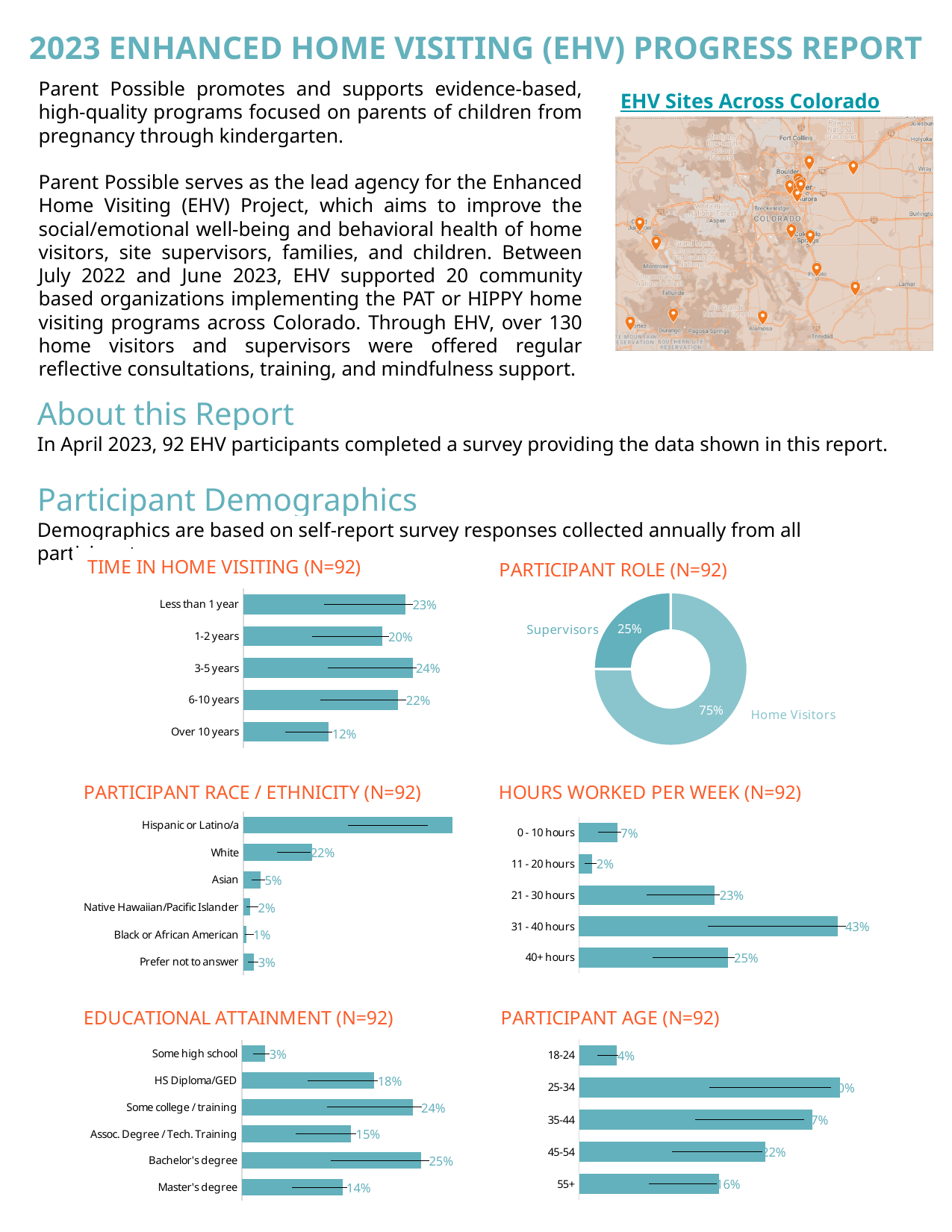
In the Participant Age chart, what percentage of participants are aged 45-54? 22% In the Time in Home Visiting chart, which category has the lowest percentage? Over 10 years In the Hours Worked Per Week chart, how many hour categories are shown? 5 In the Educational Attainment chart, which is larger: HS Diploma/GED or Master's degree? HS Diploma/GED In the Time in Home Visiting chart, what percentage of participants have been in home visiting for 3-5 years? 24% In the Educational Attainment chart, which category has the highest percentage? Bachelor's degree In the Participant Race / Ethnicity chart, what percentage of participants are White? 22% In the Participant Race / Ethnicity chart, which category has the highest percentage? Hispanic or Latino/a What type of chart is the Participant Role chart? Donut chart In the Participant Role chart, what share of participants are Supervisors? 25% In the Hours Worked Per Week chart, what percentage of participants work 31 - 40 hours? 43% In the Hours Worked Per Week chart, what is the difference between the 40+ hours and 21 - 30 hours percentages? 2%